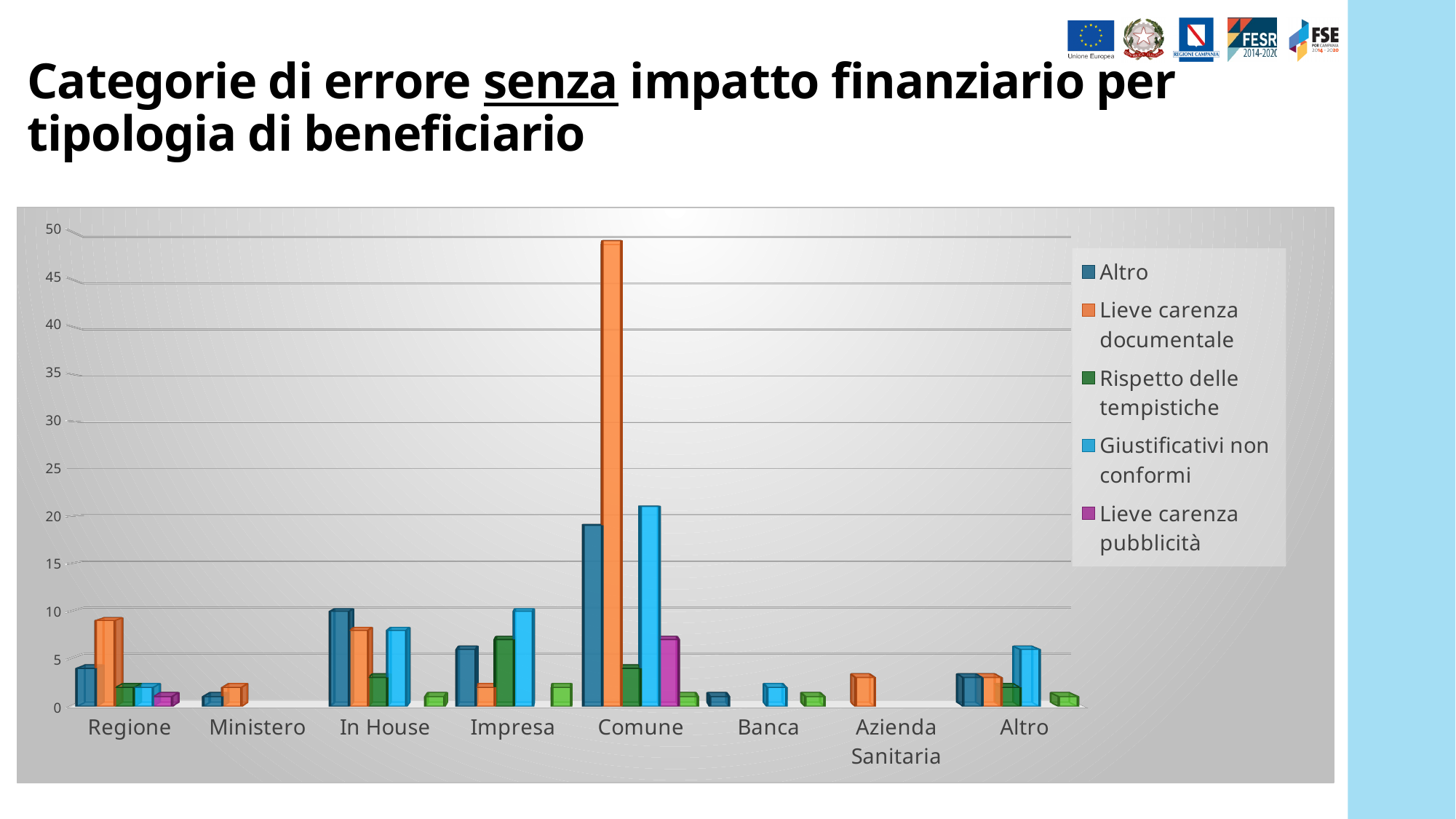
Which category has the highest value for Giustificativi non conformi? Comune Is the value for Lieve carenza documentale in Regione greater or less than 10? less Which category has the highest value for Lieve carenza documentale? Comune Which category has the highest value for Altro? Comune Which series is shown in orange in the legend? Lieve carenza documentale Is the value for Giustificativi non conformi in Comune greater or less than 15? greater What kind of chart is shown on the slide? bar chart Is the value for Lieve carenza documentale in Comune greater or less than 45? greater How many series does the legend list? 5 In Regione, which is larger: Altro or Lieve carenza documentale? Lieve carenza documentale How many beneficiary categories are shown on the x axis? 8